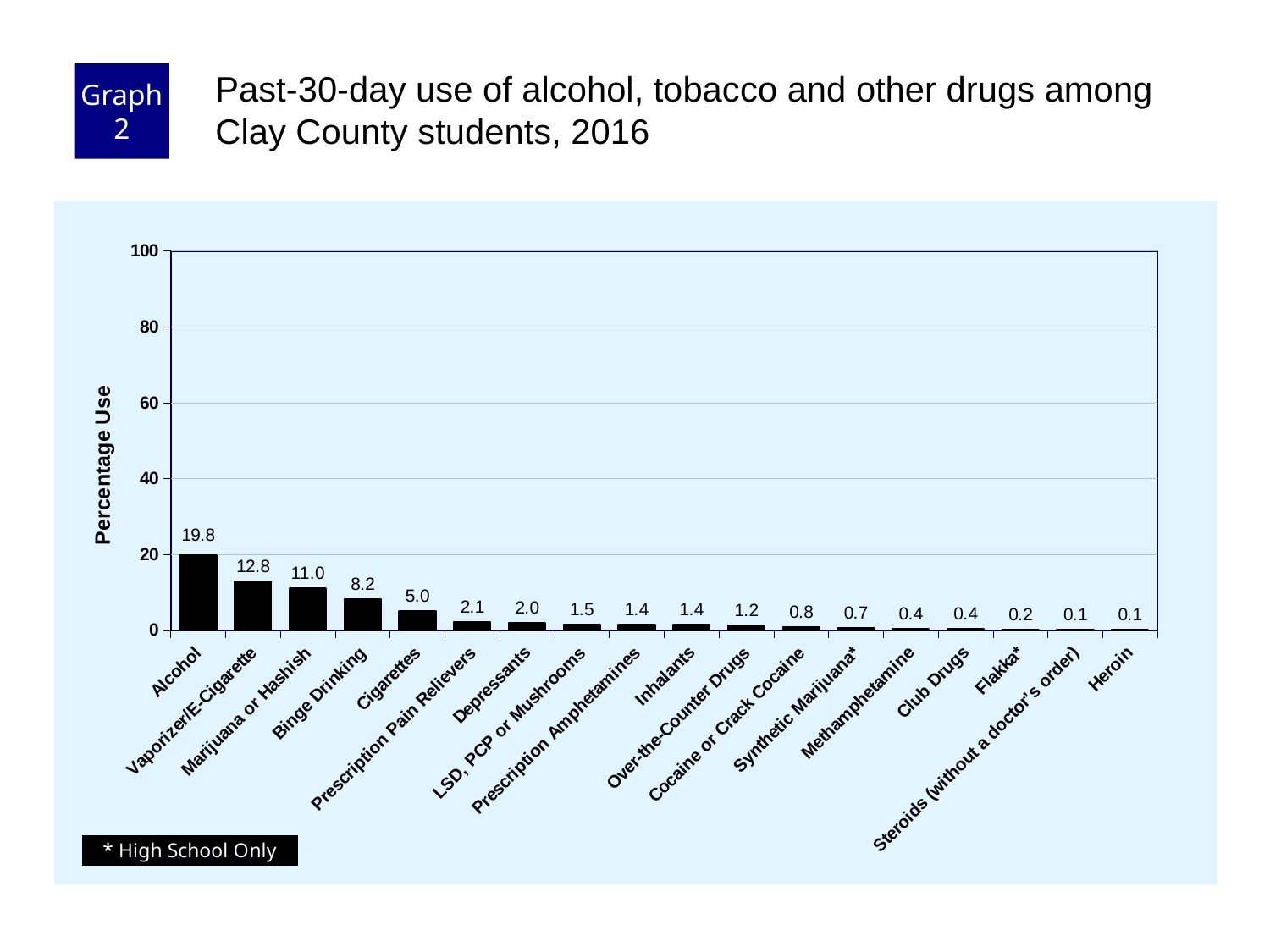
Which is larger, the value for Depressants or the value for Inhalants? Depressants What is the percentage use value for Alcohol? 19.8 What is the label of the y axis? Percentage Use What kind of chart is shown on the slide? bar chart What is the percentage use value for Vaporizer/E-Cigarette? 12.8 What is the percentage use value for Cocaine or Crack Cocaine? 0.8 Which category has the highest percentage use? Alcohol What is the percentage use value for Binge Drinking? 8.2 How many categories are shown on the x axis? 18 What is the difference between the values for Cigarettes and Prescription Pain Relievers? 2.9 Is the value for Alcohol greater or less than 20? less What is the difference between the values for Alcohol and Marijuana or Hashish? 8.8